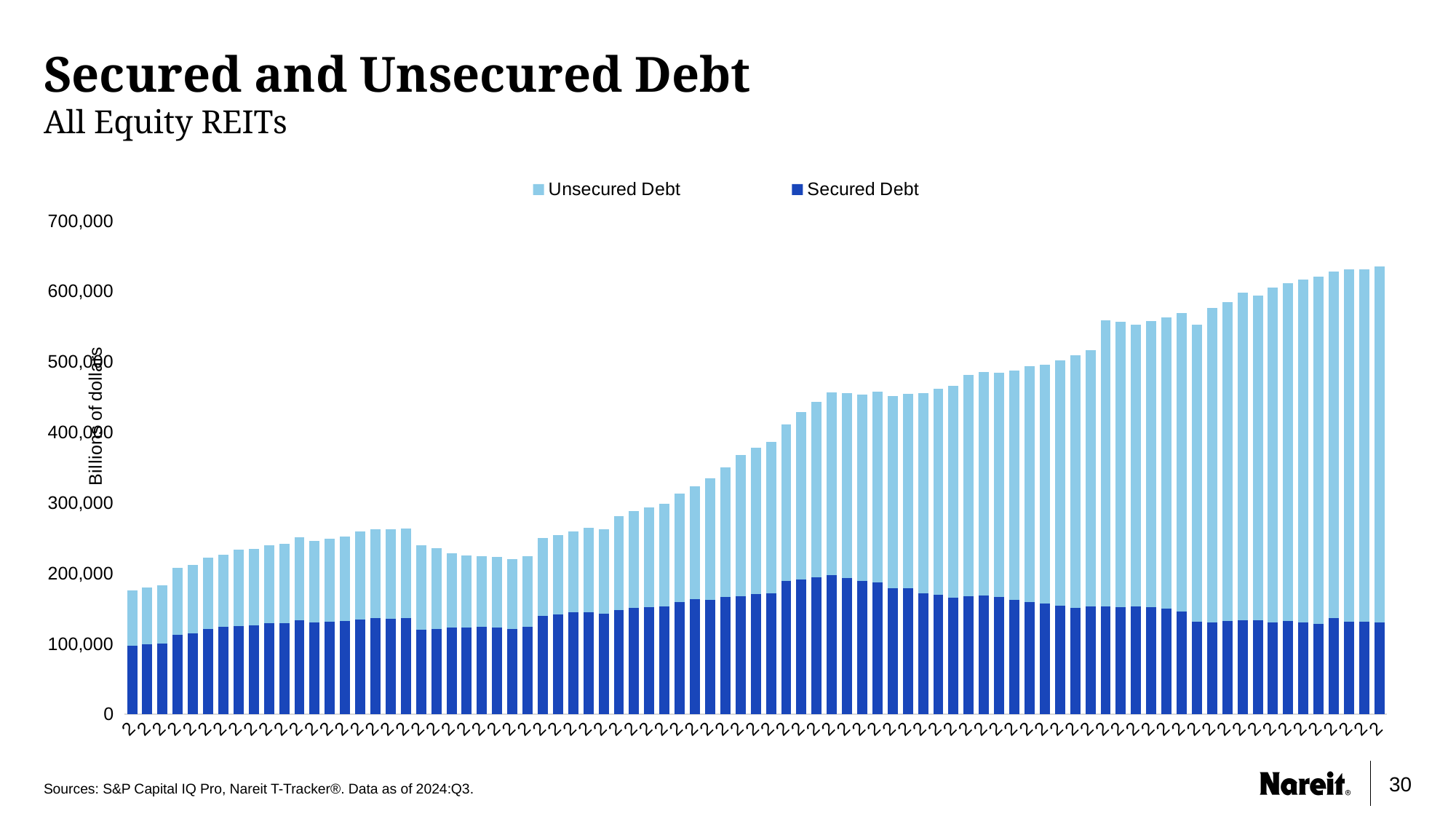
In the rightmost bar, is the Secured Debt portion greater or less than 200,000? less In the rightmost bar, which is larger: the Unsecured Debt portion or the Secured Debt portion? Unsecured Debt Is the total height of the rightmost bar greater or less than 600,000? greater What is the label on the vertical axis? Billions of dollars Is the total height of the leftmost bar greater or less than 100,000? greater How many series does the legend list? 2 What are the two series named in the legend? Unsecured Debt and Secured Debt Which series accounts for most of the growth in total debt across the chart, Unsecured Debt or Secured Debt? Unsecured Debt Does the total debt (full stacked bar) generally rise or fall from the left of the chart to the right? Rise What kind of chart is shown on the slide? Stacked bar chart